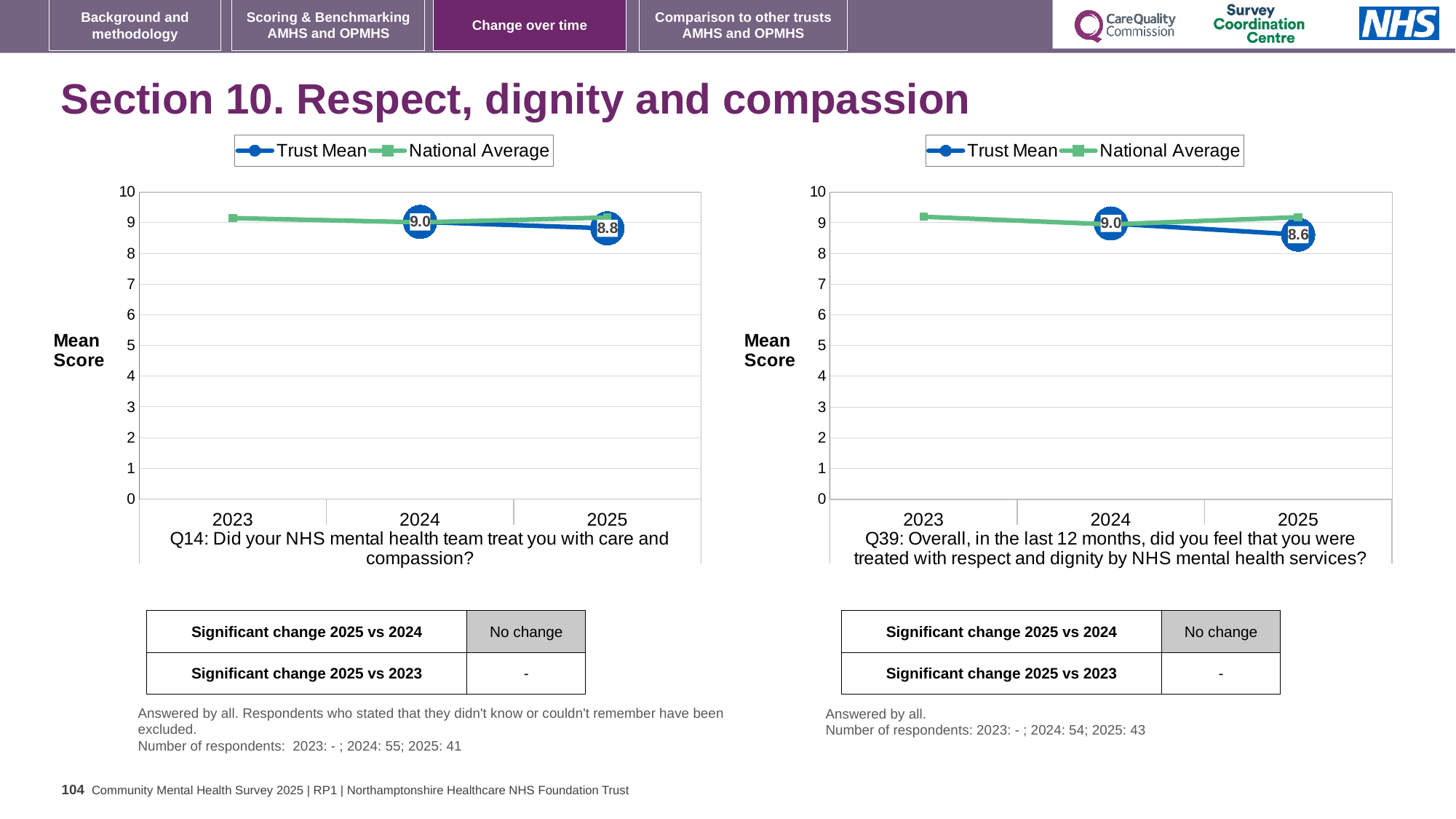
In the Q14 chart on the left, what is the Trust Mean value for 2025? 8.8 In the Q39 chart on the right, what is the Trust Mean value for 2024? 9.0 How many series does the legend of the Q39 chart on the right list? 2 In the Q39 chart on the right, what is the difference between the Trust Mean in 2024 and in 2025? 0.4 In the Q39 chart on the right, does the Trust Mean rise or fall from 2024 to 2025? fall In the Q14 chart on the left, which year has the higher Trust Mean, 2024 or 2025? 2024 What kind of chart is the Q14 chart on the left? line chart In the Q14 chart on the left, what is the Trust Mean value for 2024? 9.0 How many years are shown on the x axis of the Q14 chart on the left? 3 In the Q39 chart on the right, what is the Trust Mean value for 2025? 8.6 In the Q14 chart on the left, by how much did the Trust Mean fall from 2024 to 2025? 0.2 In the Q39 chart on the right, is the National Average value for 2023 greater or less than 8? greater